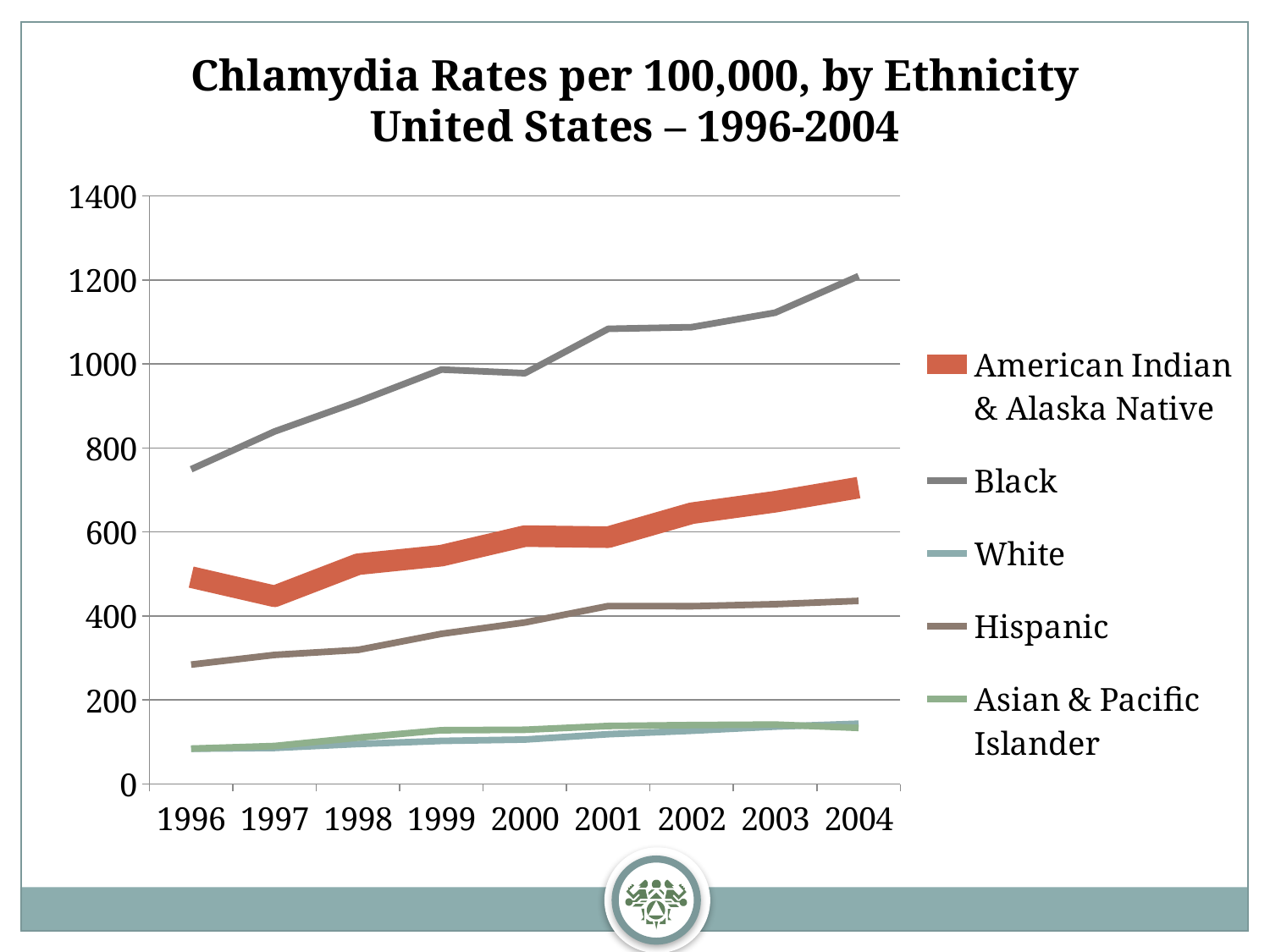
What kind of chart is shown on the slide? line chart Which ethnicity has the highest chlamydia rate in 2004? Black Which is larger, the rate for Hispanic in 2004 or the rate for American Indian & Alaska Native in 2004? American Indian & Alaska Native Is the value for Hispanic in 2004 greater or less than 400? greater What is the title of the chart? Chlamydia Rates per 100,000, by Ethnicity United States – 1996-2004 Does the rate for Black rise or fall from 1996 to 2004? rise How many years are shown on the x axis? 9 Is the value for Black in 1996 greater or less than 800? less How many series does the legend list? 5 Is the value for American Indian & Alaska Native in 1997 greater or less than 600? less